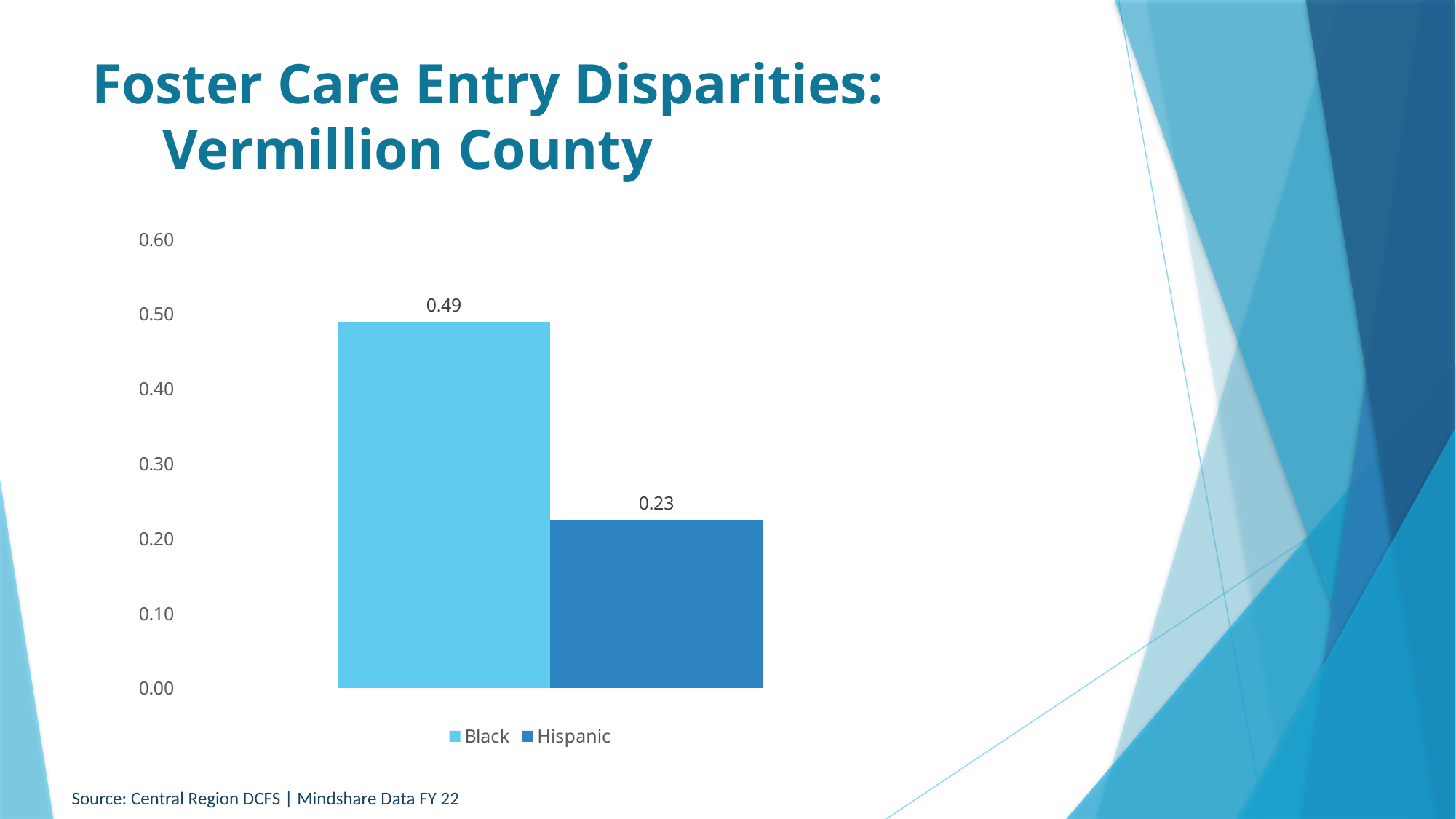
What kind of chart is shown on the slide? bar chart How many series does the legend list? 2 What is the value for Black? 0.49 What is the source cited for the chart data? Central Region DCFS | Mindshare Data FY 22 What is the difference between the values for Black and Hispanic? 0.26 How many bars are plotted on the chart? 2 Which series has the highest value? Black What is the value for Hispanic? 0.23 Which is larger, the value for Black or the value for Hispanic? Black Is the value for Hispanic greater or less than 0.30? less Is the value for Black greater or less than 0.40? greater Which series has the lowest value? Hispanic